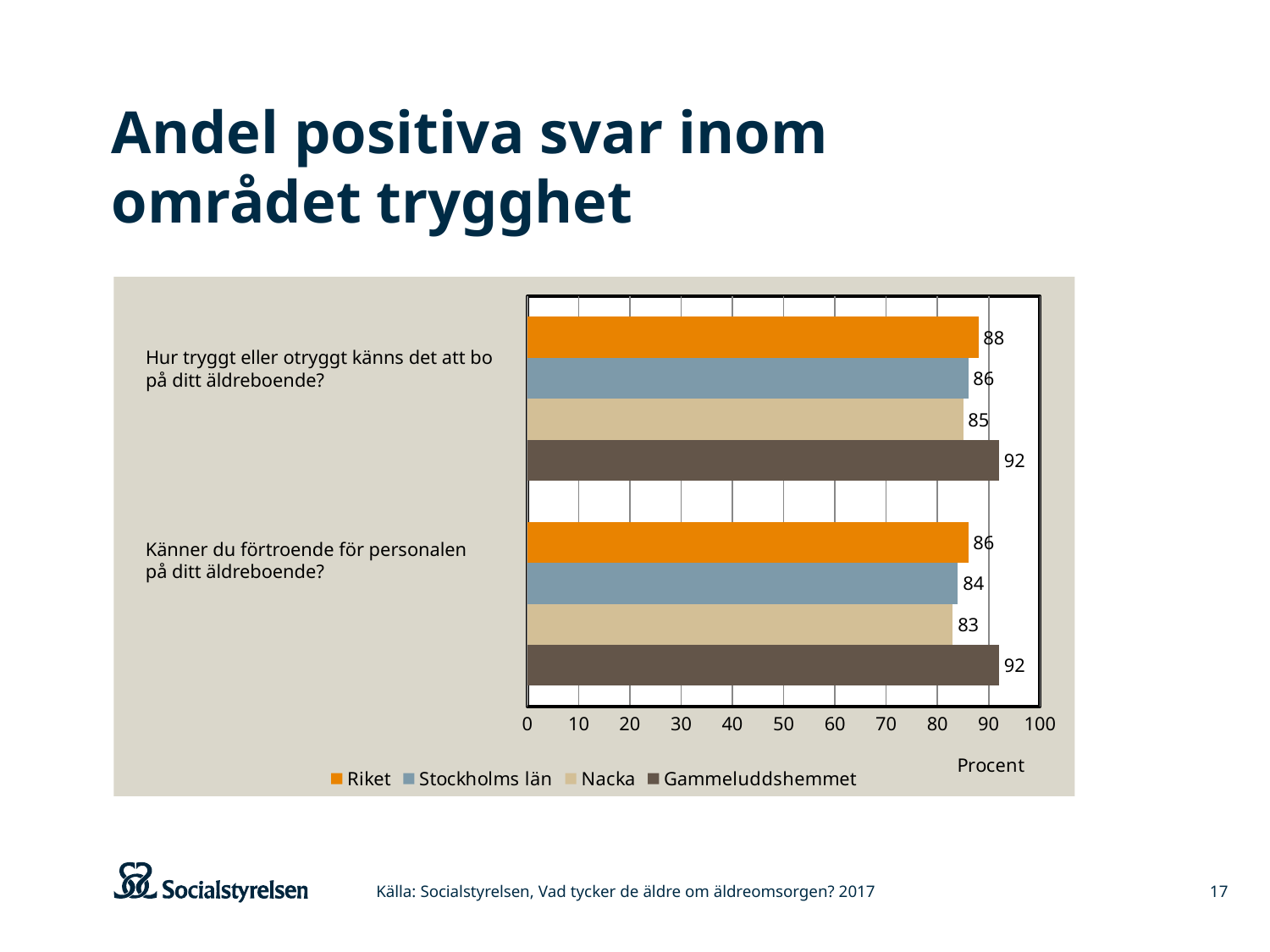
What is the value for Gammeluddshemmet for the question "Hur tryggt eller otryggt känns det att bo på ditt äldreboende?"? 92 What kind of chart is shown on the slide? Bar chart What is the value for Riket for the question "Känner du förtroende för personalen på ditt äldreboende?"? 86 Which series has the highest value for the question "Känner du förtroende för personalen på ditt äldreboende?"? Gammeluddshemmet What unit is shown on the x axis of the chart? Procent Which series has the lowest value for the question "Hur tryggt eller otryggt känns det att bo på ditt äldreboende?"? Nacka What is the difference between Gammeluddshemmet and Nacka for the question "Känner du förtroende för personalen på ditt äldreboende?"? 9 What is the difference between Riket and Stockholms län for the question "Hur tryggt eller otryggt känns det att bo på ditt äldreboende?"? 2 What is the value for Nacka for the question "Hur tryggt eller otryggt känns det att bo på ditt äldreboende?"? 85 Which is larger for the question "Hur tryggt eller otryggt känns det att bo på ditt äldreboende?": Riket or Gammeluddshemmet? Gammeluddshemmet How many series does the legend list? 4 What is the value for Stockholms län for the question "Känner du förtroende för personalen på ditt äldreboende?"? 84